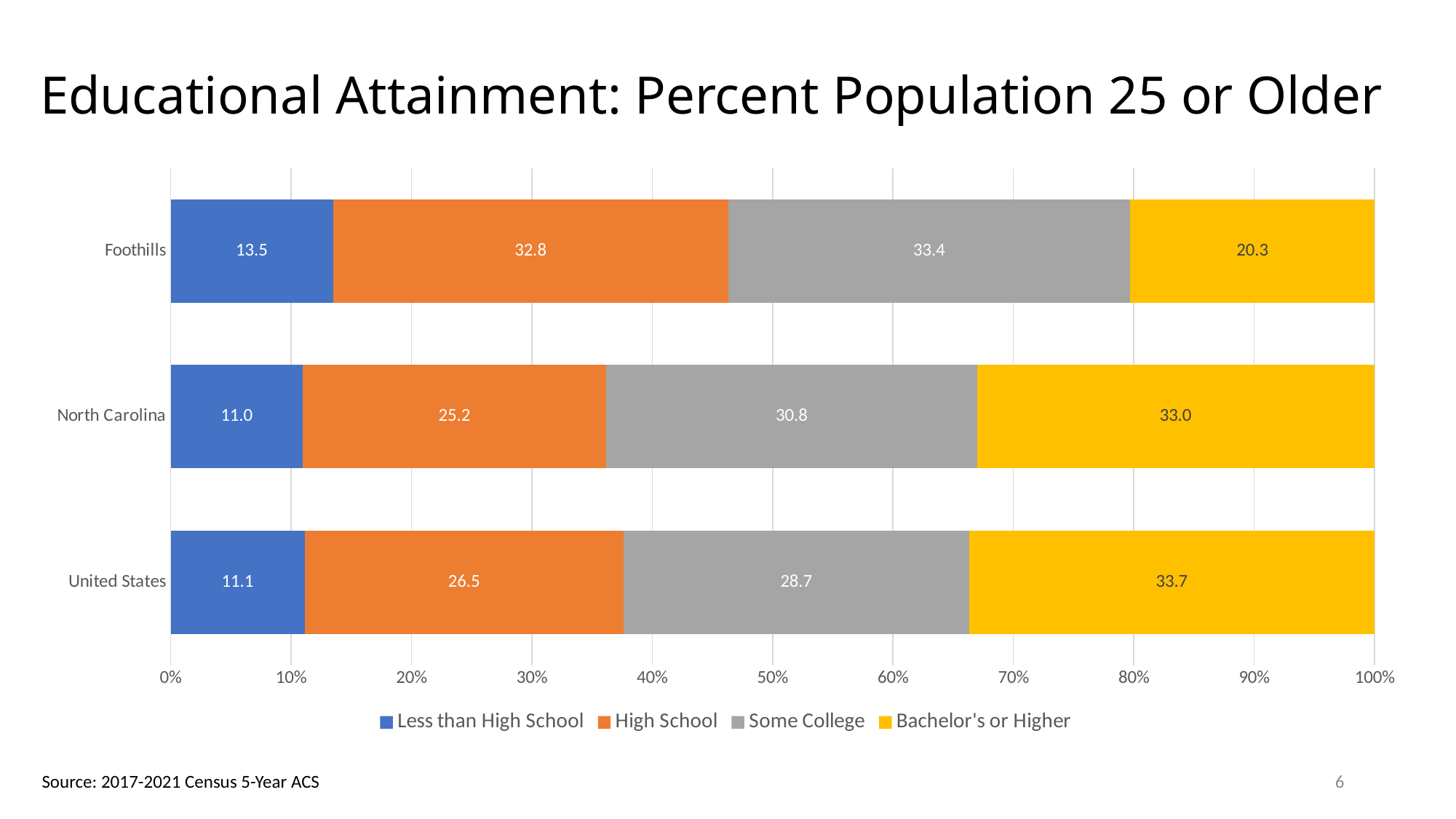
Which is larger, the High School value for Foothills or for the United States? Foothills How many regions are shown on the chart? 3 Which region has the highest Less than High School value? Foothills What is the total of the Foothills bar? 100.0 What is the High School value for North Carolina? 25.2 What is the difference between the Bachelor's or Higher values for the United States and Foothills? 13.4 How many series does the legend list? 4 What is the Bachelor's or Higher value for Foothills? 20.3 Which region has the lowest Bachelor's or Higher value? Foothills What colour represents the Some College series? Gray What is the Some College value for the United States? 28.7 What kind of chart is shown on the slide? Stacked bar chart